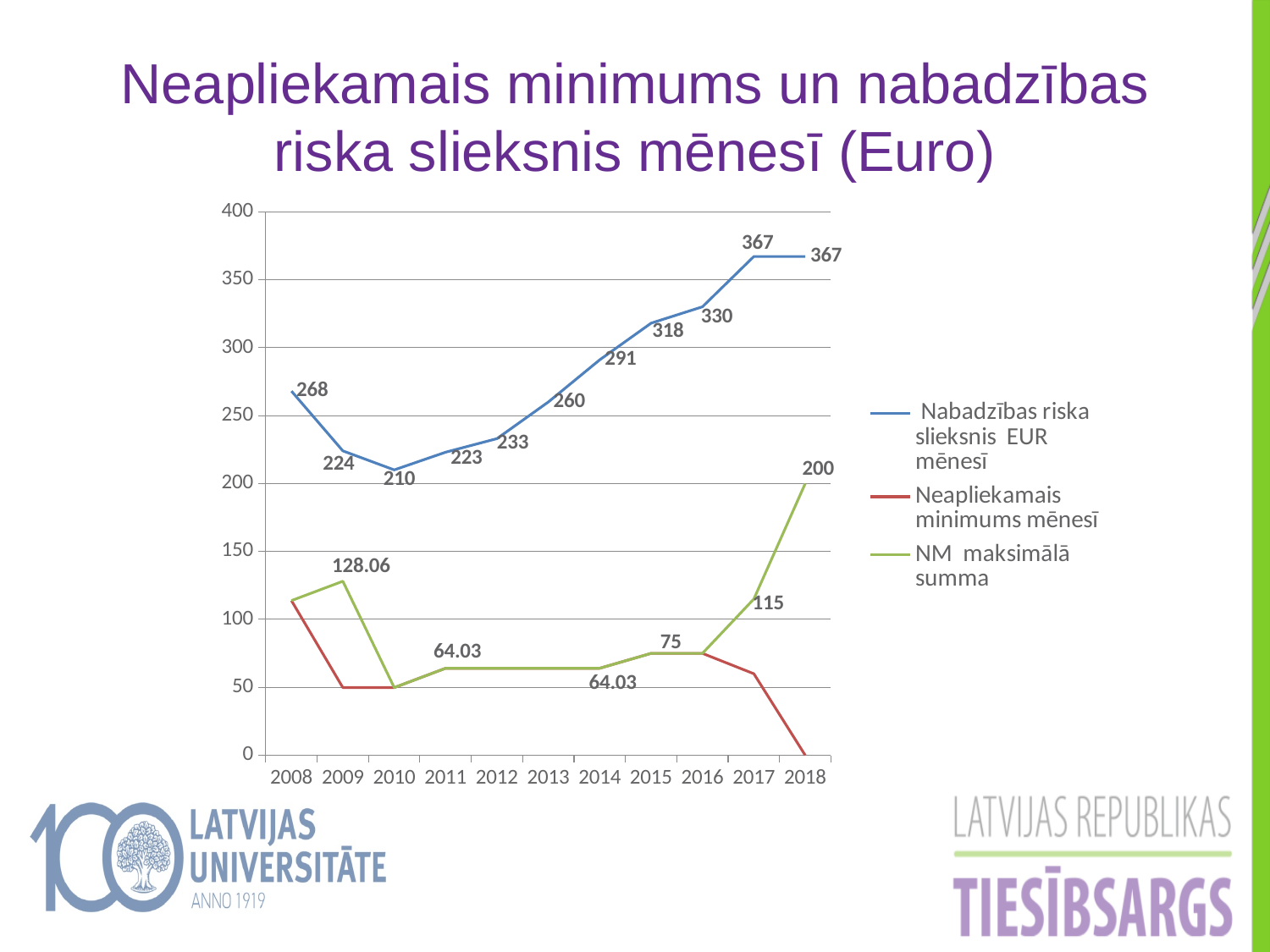
How many years are shown on the x axis? 11 In which year is the Nabadzības riska slieksnis EUR mēnesī series at its lowest? 2010 Is the value of the Neapliekamais minimums mēnesī series in 2009 greater or less than 100? less How many series does the legend list? 3 What is the value of the NM maksimālā summa series in 2018? 200 Which year has the larger Nabadzības riska slieksnis EUR mēnesī value, 2015 or 2016? 2016 What is the difference between the Nabadzības riska slieksnis EUR mēnesī values for 2017 and 2008? 99 What is the value of the Nabadzības riska slieksnis EUR mēnesī series in 2008? 268 Does the Nabadzības riska slieksnis EUR mēnesī series rise or fall from 2010 to 2017? rise What is the value of the Nabadzības riska slieksnis EUR mēnesī series in 2014? 291 What kind of chart is shown on the slide? line chart What is the value of the NM maksimālā summa series in 2009? 128.06